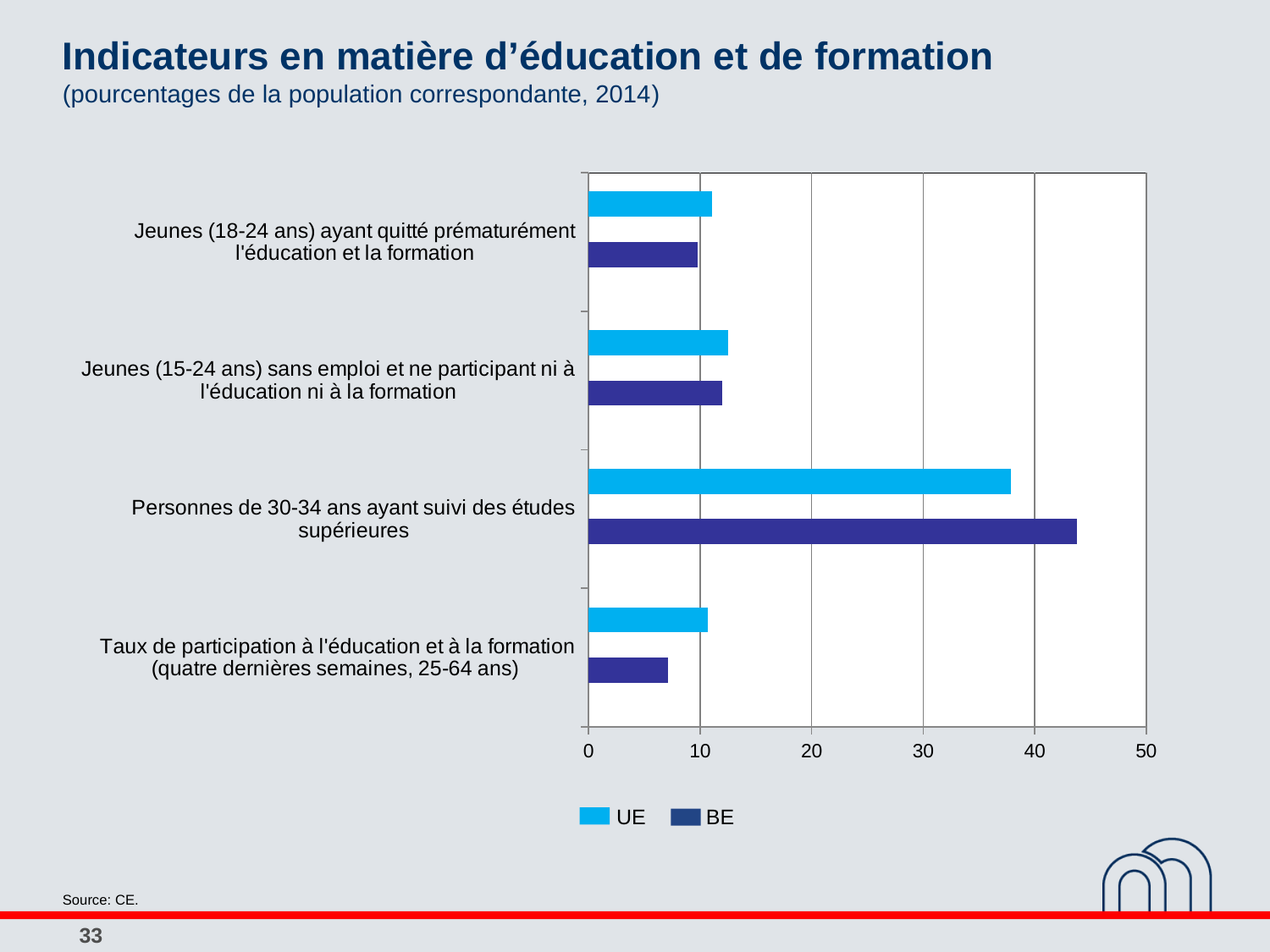
What kind of chart is shown on the slide? Bar chart Is the BE value for 'Taux de participation à l'éducation et à la formation (quatre dernières semaines, 25-64 ans)' greater or less than 10? less How many series does the legend list? 2 Is the UE value for 'Personnes de 30-34 ans ayant suivi des études supérieures' greater or less than 40? less Which category has the highest BE value? Personnes de 30-34 ans ayant suivi des études supérieures Is the BE value for 'Personnes de 30-34 ans ayant suivi des études supérieures' greater or less than 40? greater How many indicator categories are plotted on the chart? 4 Which category has the lowest BE value? Taux de participation à l'éducation et à la formation (quatre dernières semaines, 25-64 ans) For 'Personnes de 30-34 ans ayant suivi des études supérieures', which is larger, UE or BE? BE Which series are listed in the legend? UE and BE For 'Taux de participation à l'éducation et à la formation (quatre dernières semaines, 25-64 ans)', which is larger, UE or BE? UE